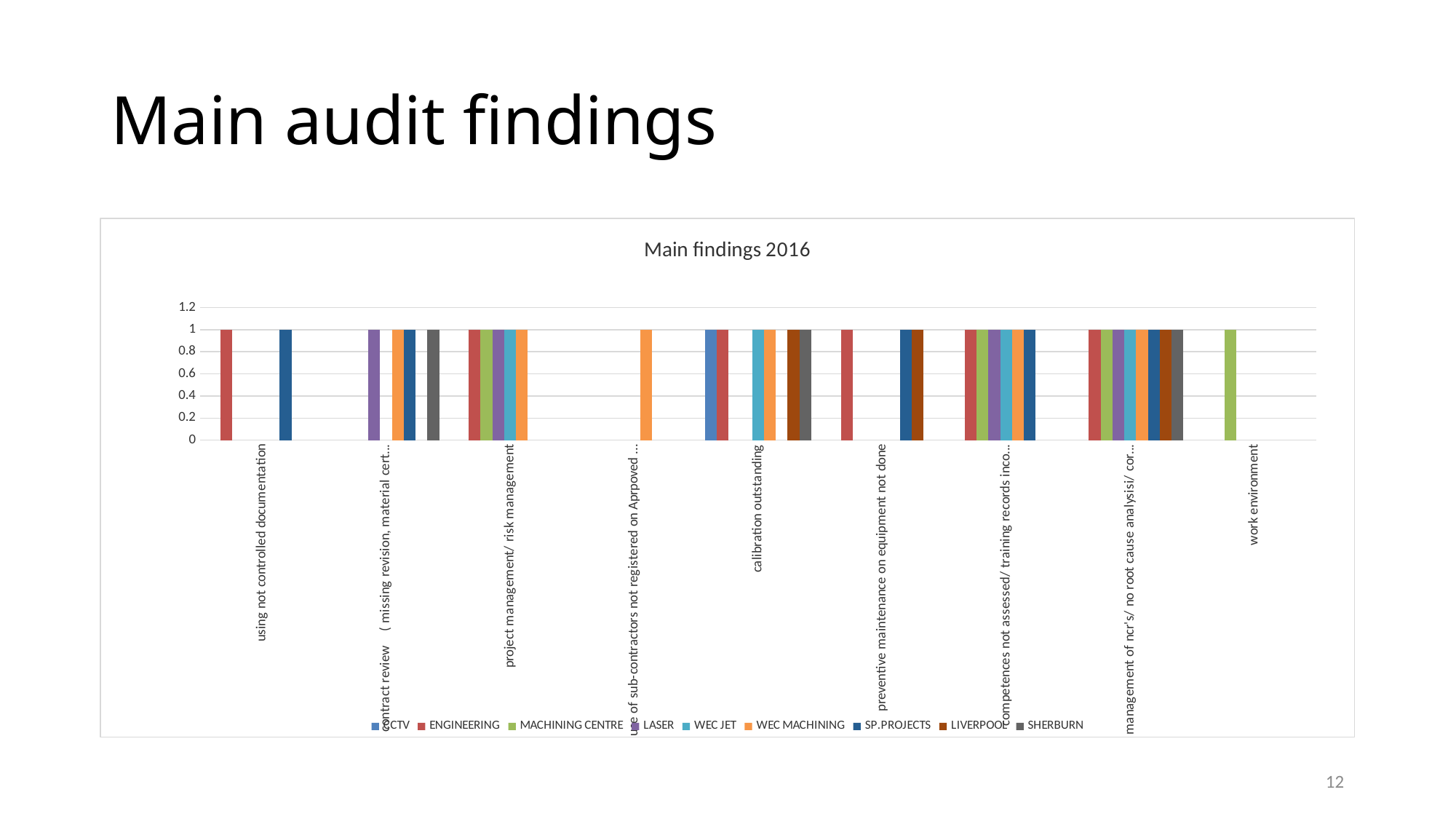
What is the value for ENGINEERING in the 'using not controlled documentation' category? 1 What type of chart is shown on the slide? Bar chart What is the highest value shown on the y axis? 1.2 Which series is the only one with a bar in the 'work environment' category? MACHINING CENTRE How many series does the legend list? 9 How many series have a bar in the 'management of ncr's/ no root cause analysis/ cor...' category? 8 What is the value for SP.PROJECTS in the 'contract review' category? 1 How many finding categories are shown along the x axis? 9 What is the value for MACHINING CENTRE in the 'work environment' category? 1 Is the value for WEC MACHINING in the 'use of sub-contractors not registered on Approved ...' category greater or less than 0.6? greater How many series have a bar in the 'preventive maintenance on equipment not done' category? 3 What is the title of the chart? Main findings 2016